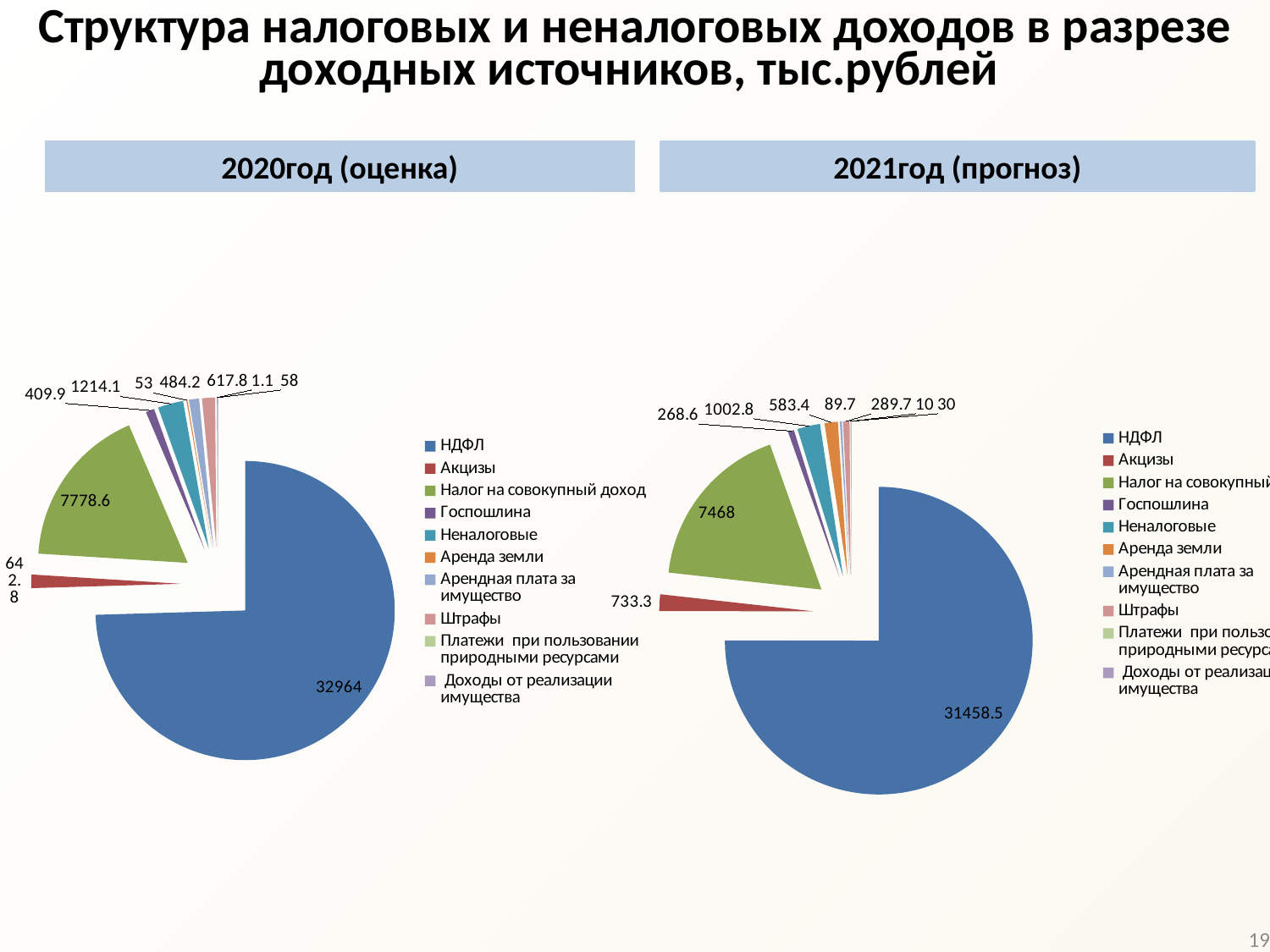
In the 2021год (прогноз) pie chart, which category has the largest slice? НДФЛ What unit of measurement is stated in the slide title for the charts? тыс.рублей In the 2020год (оценка) pie chart, what is the value for НДФЛ? 32964 In the 2021год (прогноз) pie chart, what is the value for Налог на совокупный доход? 7468 How many entries does the legend of the 2020год (оценка) chart list? 10 In the 2020год (оценка) pie chart, what is the value for Налог на совокупный доход? 7778.6 In the 2020год (оценка) pie chart, which category has the largest slice? НДФЛ What type of chart is used for the 2021год (прогноз) data? Pie chart What is the difference between the НДФЛ value in the 2020год (оценка) chart and the НДФЛ value in the 2021год (прогноз) chart? 1505.5 In the 2021год (прогноз) pie chart, what is the value for НДФЛ? 31458.5 Is the value for Налог на совокупный доход larger in the 2020год (оценка) chart or in the 2021год (прогноз) chart? 2020год (оценка) In the 2021год (прогноз) pie chart, what is the value for Акцизы? 733.3